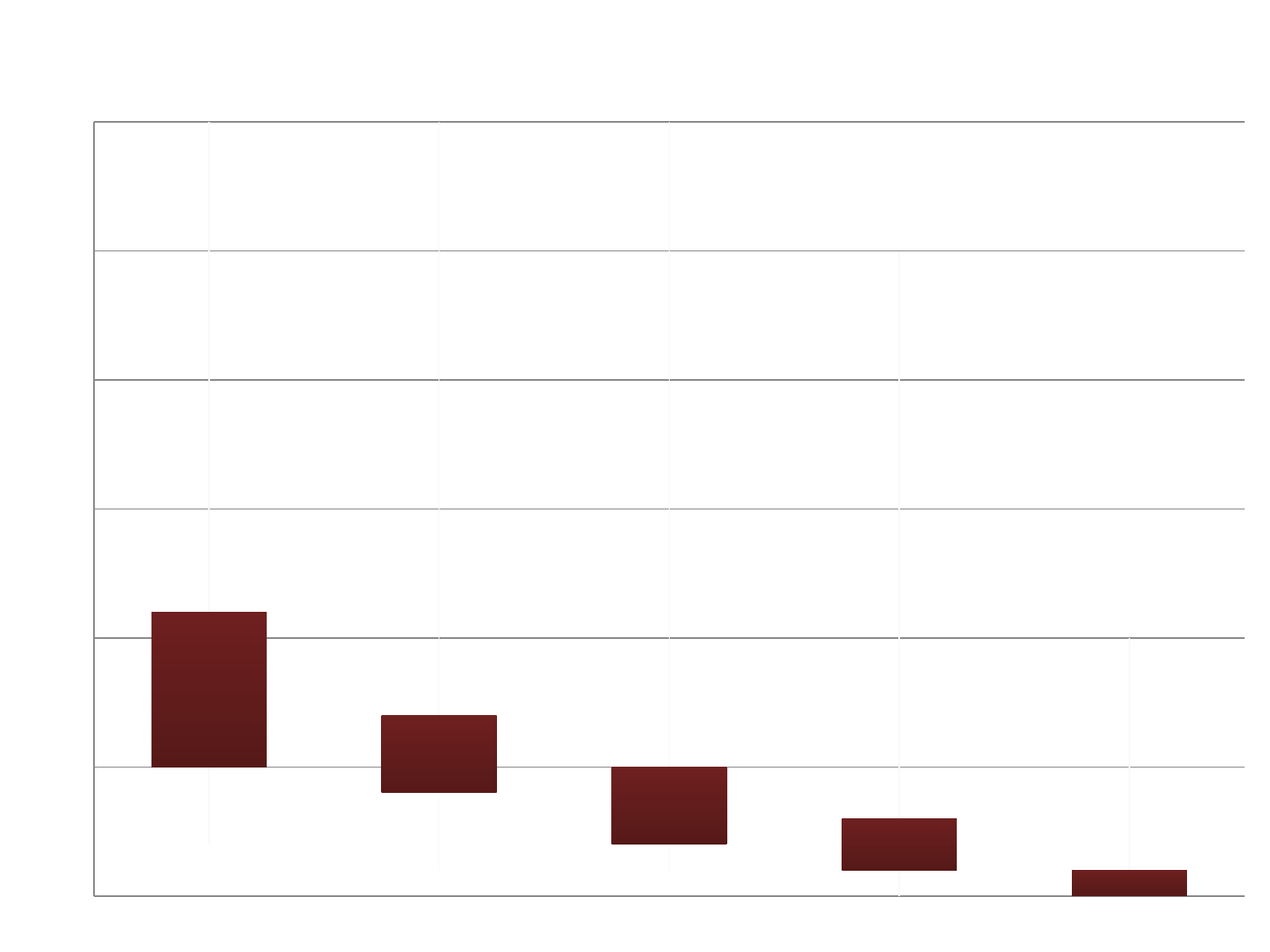
Do the bars rise or fall from left to right across the chart? fall What colour are the bars in the chart? dark red Does the chart display a legend? No How many bars are plotted in the chart? 5 What kind of chart is shown on the slide? bar chart